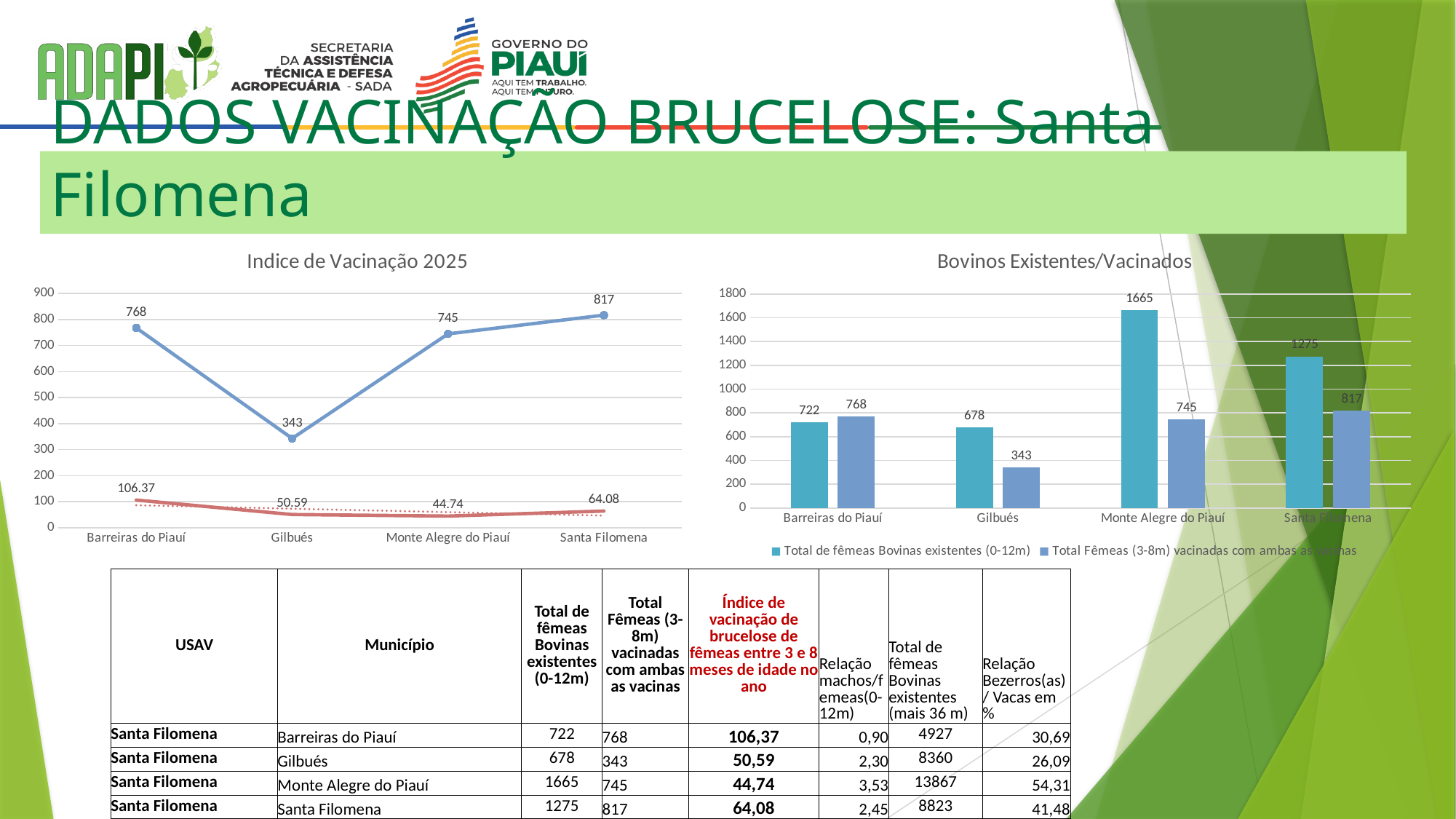
In the 'Bovinos Existentes/Vacinados' chart, what is the value of 'Total Fêmeas (3-8m) vacinadas com ambas as vacinas' for Gilbués? 343 In the 'Indice de Vacinação 2025' chart, which municipality has the highest value on the upper line? Santa Filomena In the 'Bovinos Existentes/Vacinados' chart, what is the value of 'Total de fêmeas Bovinas existentes (0-12m)' for Monte Alegre do Piauí? 1665 In the 'Indice de Vacinação 2025' chart, which municipality has the lowest value on the upper line? Gilbués In the 'Bovinos Existentes/Vacinados' chart, what is the difference between the two bars for Monte Alegre do Piauí? 920 How many municipalities are shown on the x axis of the 'Indice de Vacinação 2025' chart? 4 How many series does the legend of the 'Bovinos Existentes/Vacinados' chart list? 2 In the 'Bovinos Existentes/Vacinados' chart, which municipality has the highest value for 'Total de fêmeas Bovinas existentes (0-12m)'? Monte Alegre do Piauí In the 'Bovinos Existentes/Vacinados' chart, for Barreiras do Piauí, which is larger: the existing females (0-12m) bar or the vaccinated females (3-8m) bar? Total Fêmeas (3-8m) vacinadas com ambas as vacinas In the 'Indice de Vacinação 2025' chart, what is the lower line's value for Barreiras do Piauí? 106.37 What kind of chart is 'Bovinos Existentes/Vacinados'? Bar chart What kind of chart is 'Indice de Vacinação 2025'? Line chart